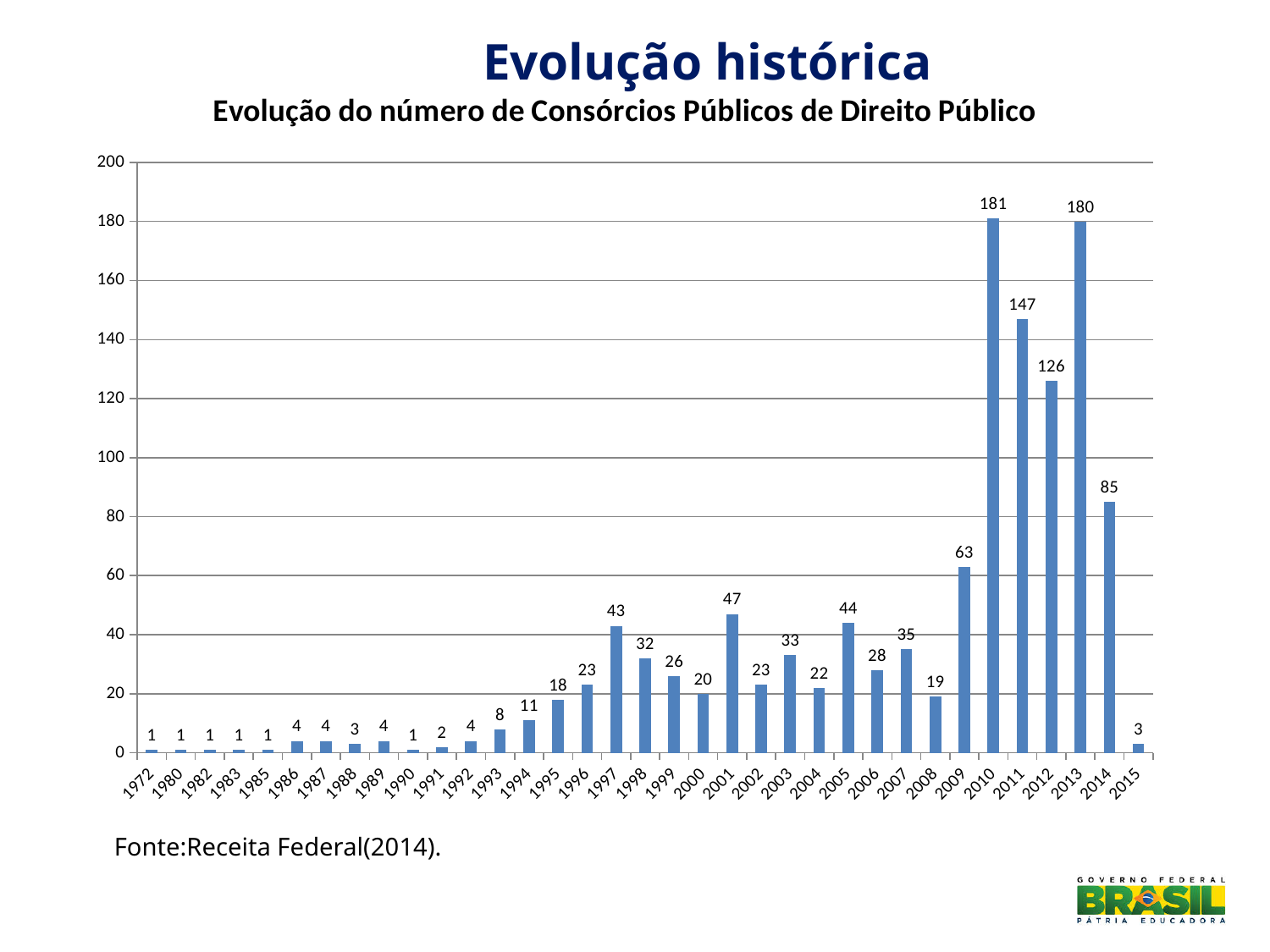
What is the value for 1997? 43 Which is larger, the value for 2001 or the value for 2005? 2001 Which year has the highest value? 2010 What is the title of the chart? Evolução do número de Consórcios Públicos de Direito Público What is the value for 2010? 181 What is the difference between the values for 2010 and 2011? 34 What kind of chart is shown on the slide? Bar chart What is the difference between the values for 2013 and 2014? 95 Do the values rise or fall from 2010 to 2012? Fall How many years are shown on the x axis? 35 What is the value for 2013? 180 What is the value for 2014? 85